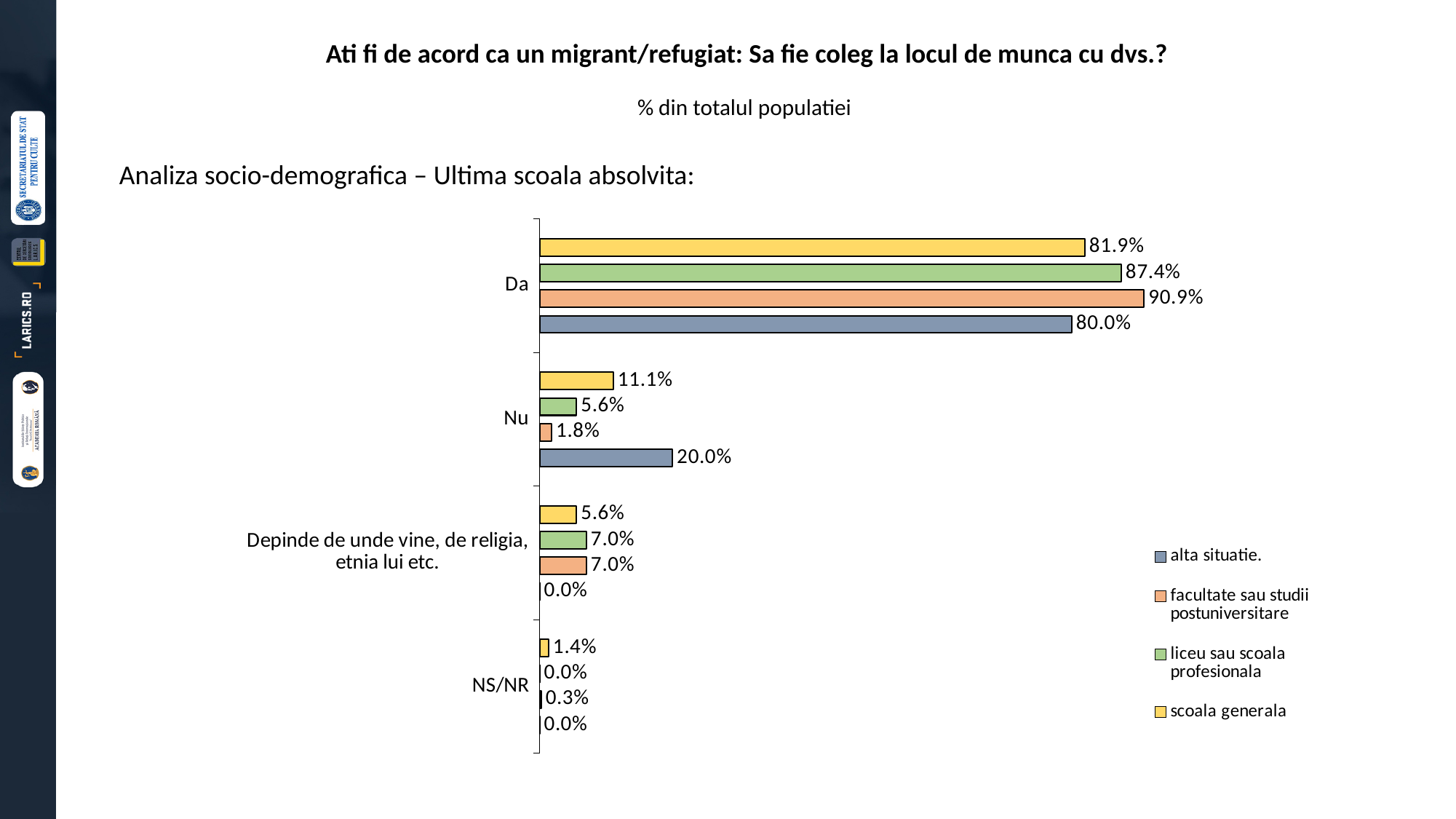
What kind of chart is shown on the slide? bar chart Which series has the lowest value in the 'Nu' category? facultate sau studii postuniversitare How many response categories are shown on the chart? 4 What is the value for 'facultate sau studii postuniversitare' in the 'Da' category? 90.9% What is the subtitle shown under the chart title? % din totalul populatiei What is the value for 'scoala generala' in the 'NS/NR' category? 1.4% What is the value for 'alta situatie.' in the 'Nu' category? 20.0% What is the value for 'liceu sau scoala profesionala' in the 'Depinde de unde vine, de religia, etnia lui etc.' category? 7.0% How many series does the legend list? 4 In the 'Da' category, which is larger: the value for 'liceu sau scoala profesionala' or the value for 'scoala generala'? liceu sau scoala profesionala Which series has the highest value in the 'Da' category? facultate sau studii postuniversitare What is the difference between the 'alta situatie.' and 'scoala generala' values in the 'Nu' category? 8.9%